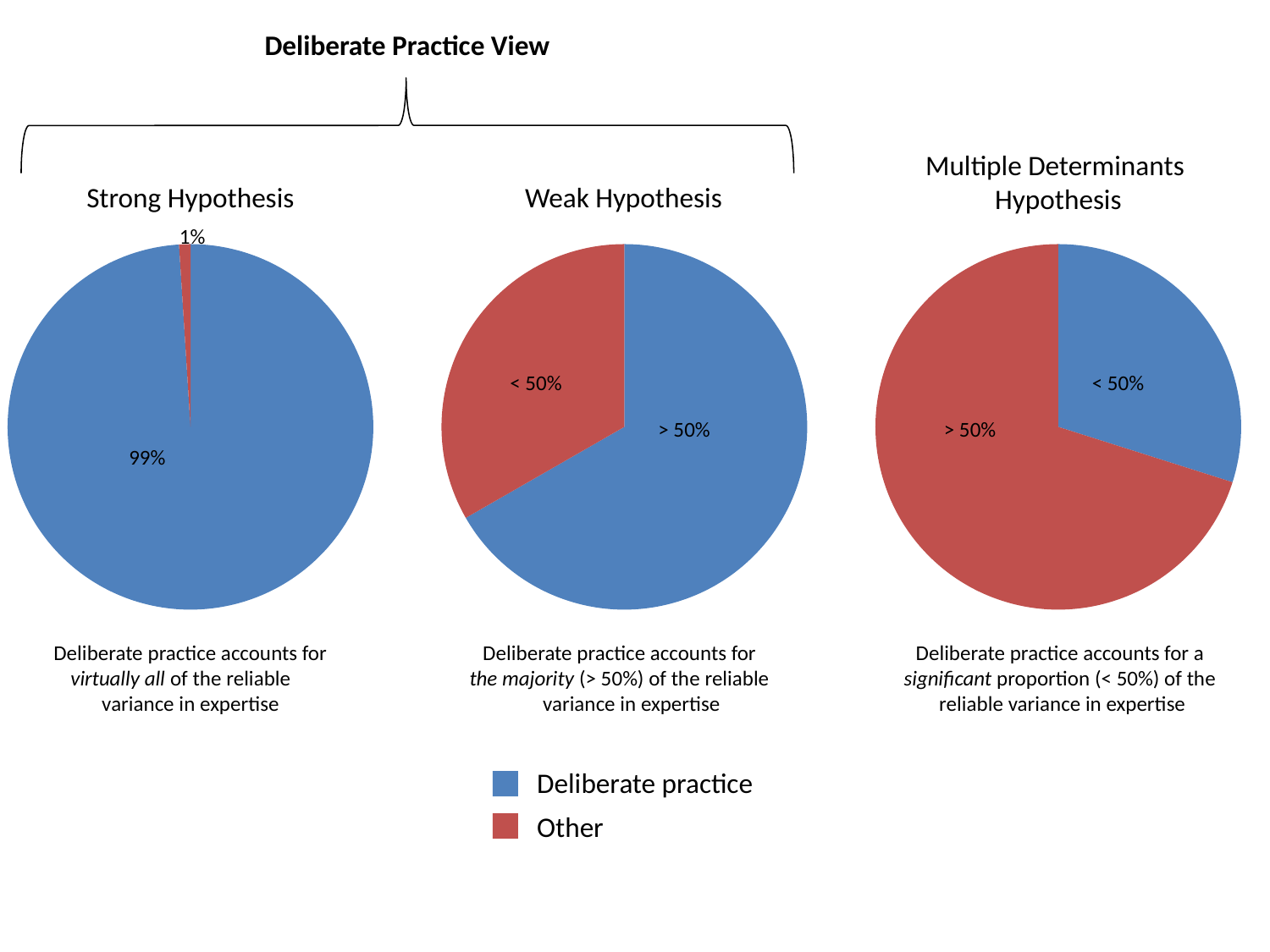
In the Multiple Determinants Hypothesis chart, which slice is the smallest? Deliberate practice How many slices does the Weak Hypothesis pie chart have? 2 What colour represents Other in the legend? red How many entries does the legend list? 2 In the Weak Hypothesis chart, which slice is larger, Deliberate practice or Other? Deliberate practice In the Strong Hypothesis chart, what share of the pie is Deliberate practice? 99% In the Strong Hypothesis chart, which slice is the largest? Deliberate practice What kind of chart is the Strong Hypothesis chart? pie chart In the Weak Hypothesis chart, what label is printed on the Other slice? < 50% In the Multiple Determinants Hypothesis chart, what label is printed on the Deliberate practice slice? < 50% In the Multiple Determinants Hypothesis chart, which slice is larger, Deliberate practice or Other? Other In the Strong Hypothesis chart, what value is shown for Other? 1%